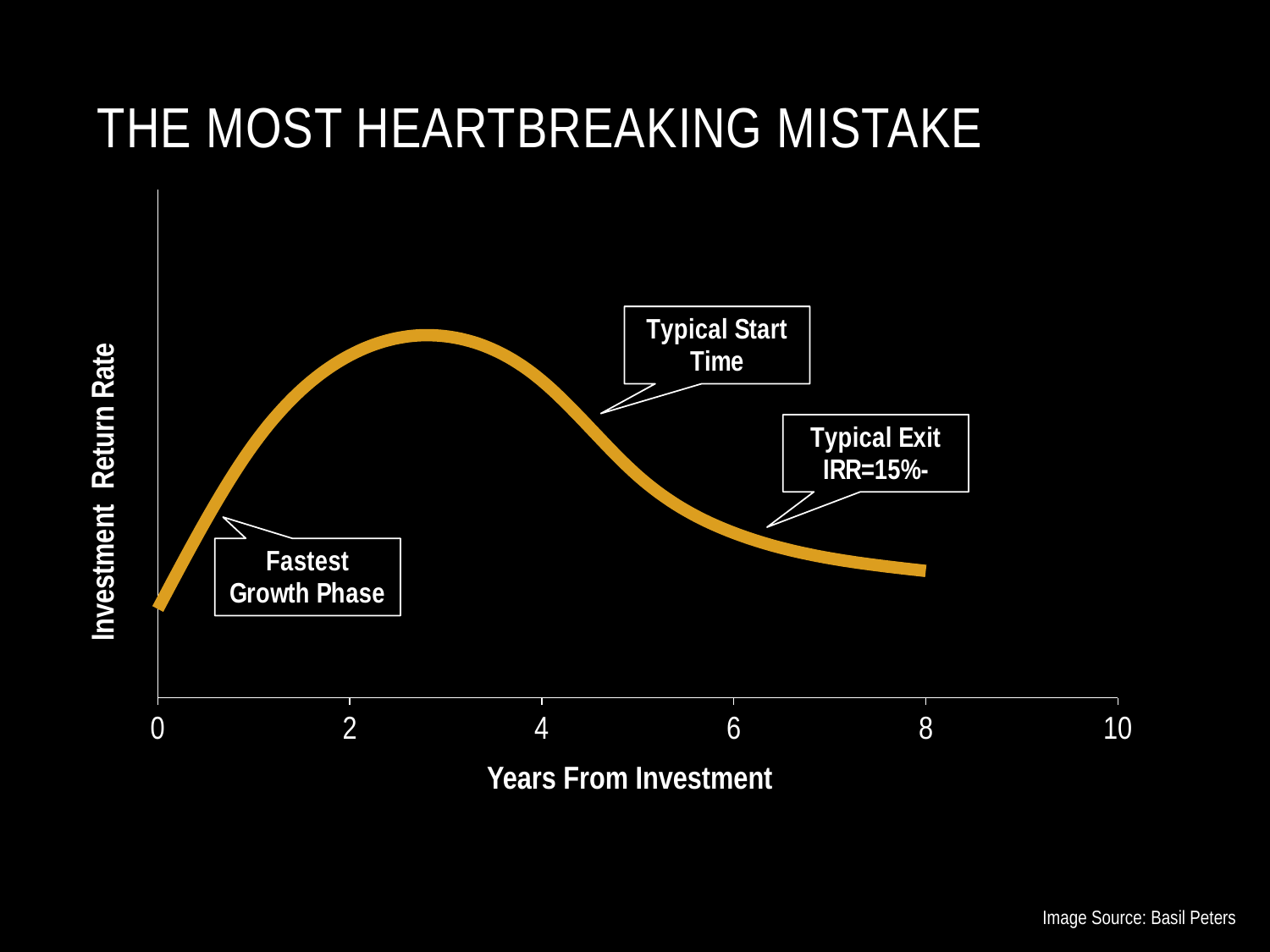
Does the investment return rate rise or fall between year 4 and year 8? Fall Does the investment return rate rise or fall between year 0 and year 2? Rise What is the highest tick value shown on the x axis? 10 Which is higher on the curve, the investment return rate at year 4 or at year 8? Year 4 What is the label of the y axis? Investment Return Rate At what value on the x axis does the plotted curve end? 8 Which is higher on the curve, the investment return rate at year 2 or at year 6? Year 2 What IRR value is given in the 'Typical Exit' callout? IRR=15%- How many tick labels are shown on the x axis? 6 How many lines (series) are plotted on the chart? 1 What kind of chart is shown on the slide? Line chart What is the label of the x axis? Years From Investment